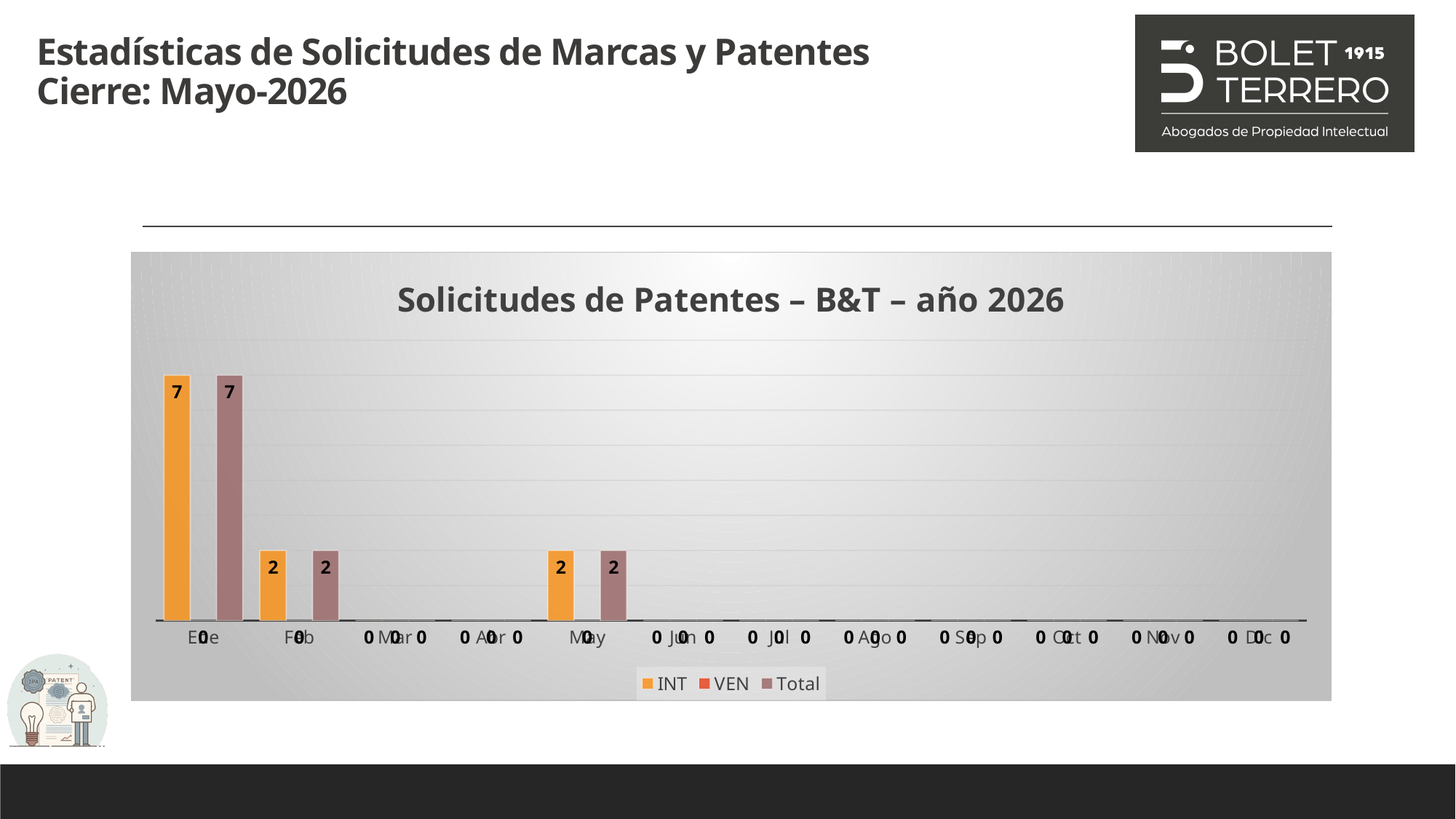
What is the INT value for Ene? 7 Which is larger, the Total value for Ene or the Total value for May? Ene How many series does the legend list? 3 What are the series names listed in the legend? INT, VEN, Total Which month has the highest Total value? Ene How many months (categories) are shown on the x axis? 12 What type of chart is shown on the slide? bar chart What is the VEN value for Ene? 0 What is the INT value for May? 2 What is the Total value for Feb? 2 What is the difference between the INT value for Ene and the INT value for Feb? 5 What is the title of the chart? Solicitudes de Patentes – B&T – año 2026